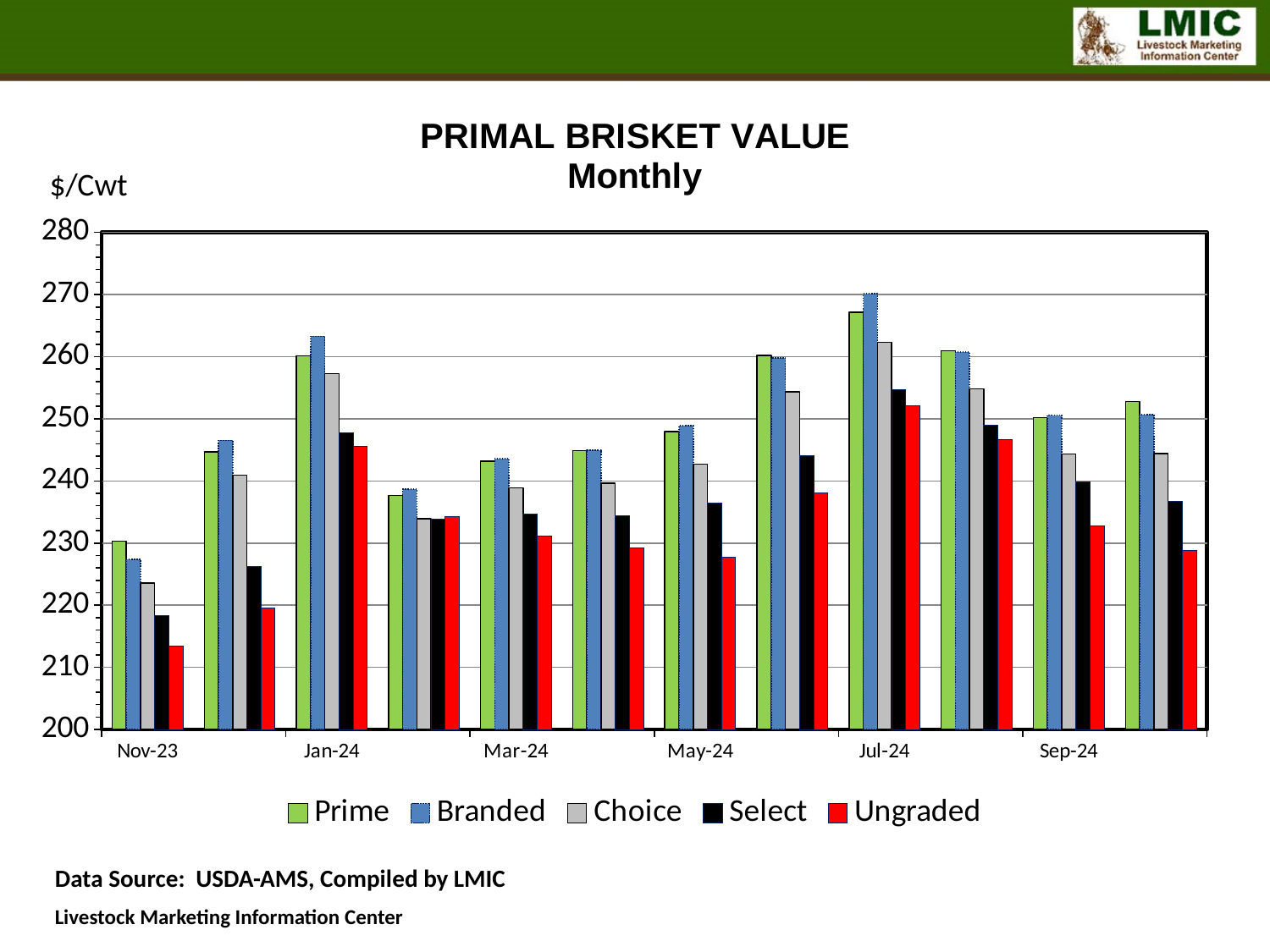
How many series does the legend list? 5 Is the Ungraded value for Nov-23 greater or less than 220? less In which month is the Ungraded value lowest? Nov-23 What kind of chart is shown on the slide? bar chart What unit is shown for the y axis? $/Cwt In Nov-23, which is larger, the Prime value or the Select value? Prime In which month is the Branded value highest? Jul-24 Is the Prime value for Jan-24 greater or less than 250? greater How many groups of bars (months) are plotted on the chart? 12 Is the Select value for Jul-24 greater or less than 250? greater Which is larger, the Choice value for Jul-24 or the Choice value for Sep-24? Jul-24